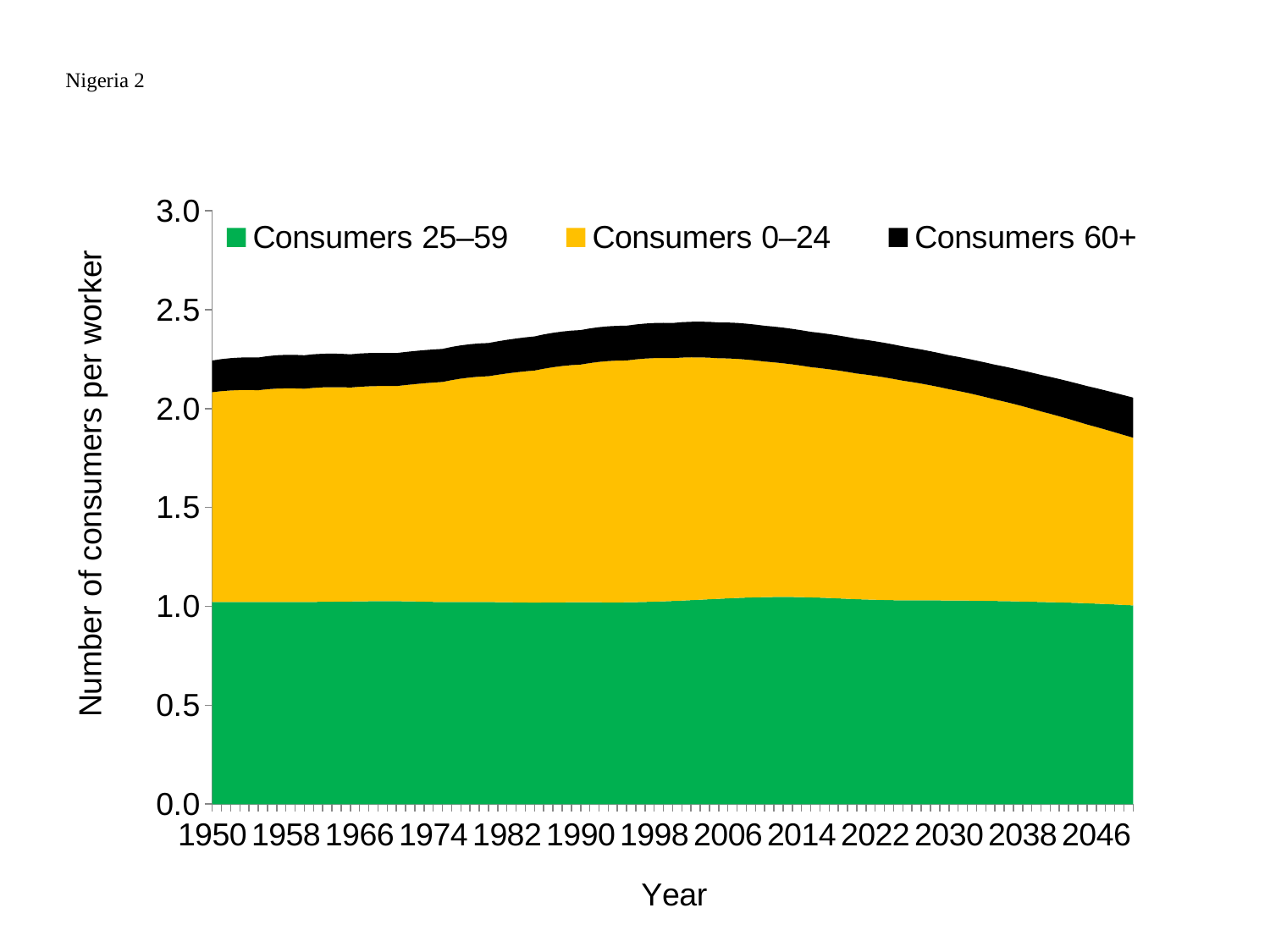
Is the Consumers 25–59 band in 2046 greater or less than 1.5? less What is the label of the y axis? Number of consumers per worker How many year labels are shown on the x axis? 13 Which series is shown in green? Consumers 25–59 Which series forms the thinnest band in the chart? Consumers 60+ What kind of chart is shown on the slide? Stacked area chart Does the total number of consumers per worker rise or fall between 2014 and 2046? fall In 2046, which is larger: the Consumers 25–59 band or the Consumers 60+ band? Consumers 25–59 How many series does the legend list? 3 Is the total number of consumers per worker in 1950 greater or less than 2.0? greater Is the total number of consumers per worker at its peak around 2002 greater or less than 2.5? less